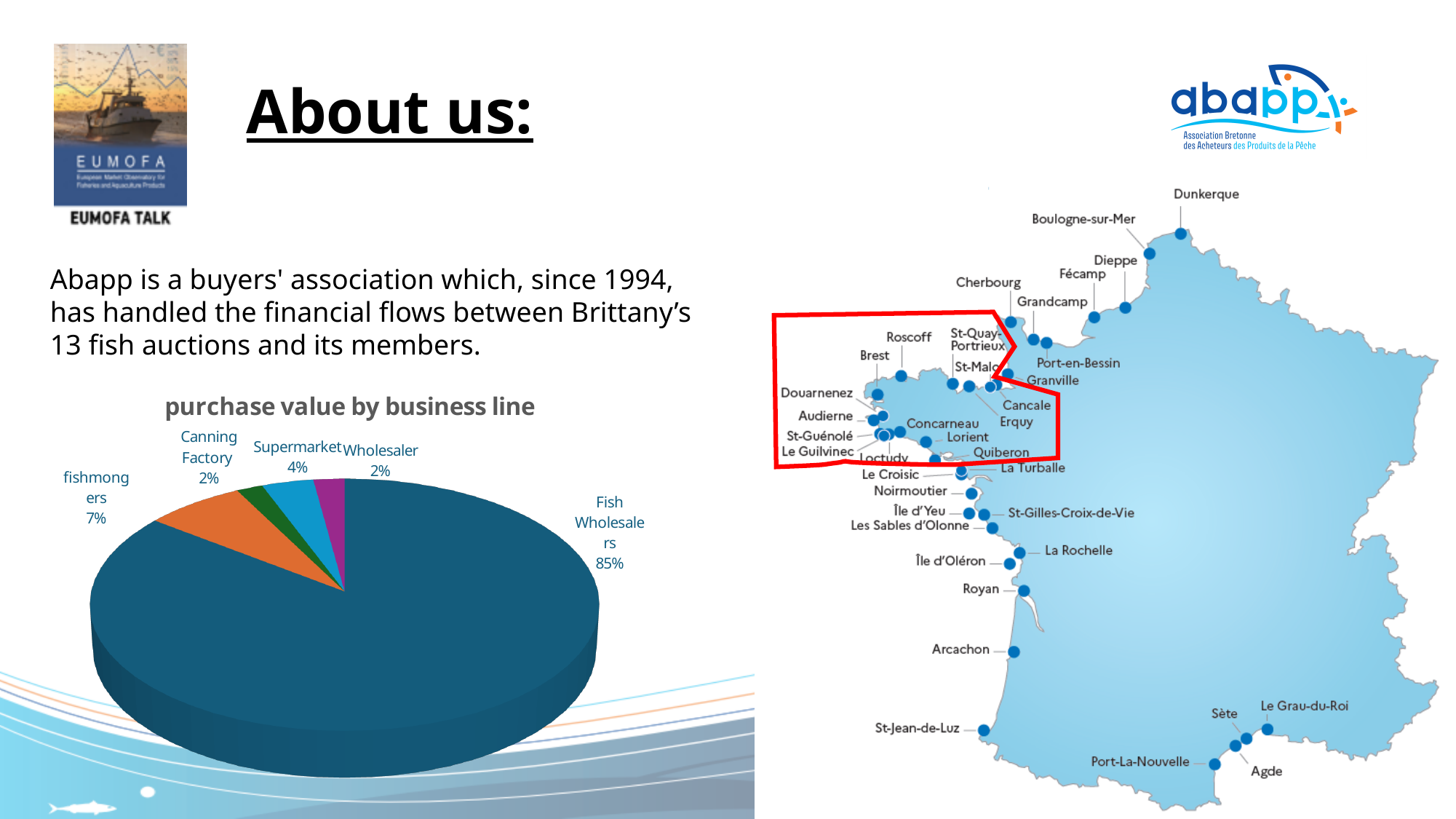
What is the combined share of the Supermarket and Wholesaler business lines? 6% What share of purchase value does the Supermarket business line account for? 4% What is the title of the pie chart on the slide? purchase value by business line Which business line has the largest share of purchase value? Fish Wholesalers How many business lines (slices) are shown in the pie chart? 5 What share of purchase value do Fish Wholesalers account for? 85% What share of purchase value does the Canning Factory business line account for? 2% Which business line is shown in orange in the pie chart? fishmongers Which has a larger share of purchase value, fishmongers or Supermarket? fishmongers What is the difference in percentage points between the Fish Wholesalers share and the fishmongers share? 78 What kind of chart is shown under the title "purchase value by business line"? pie chart What share of purchase value do fishmongers account for? 7%